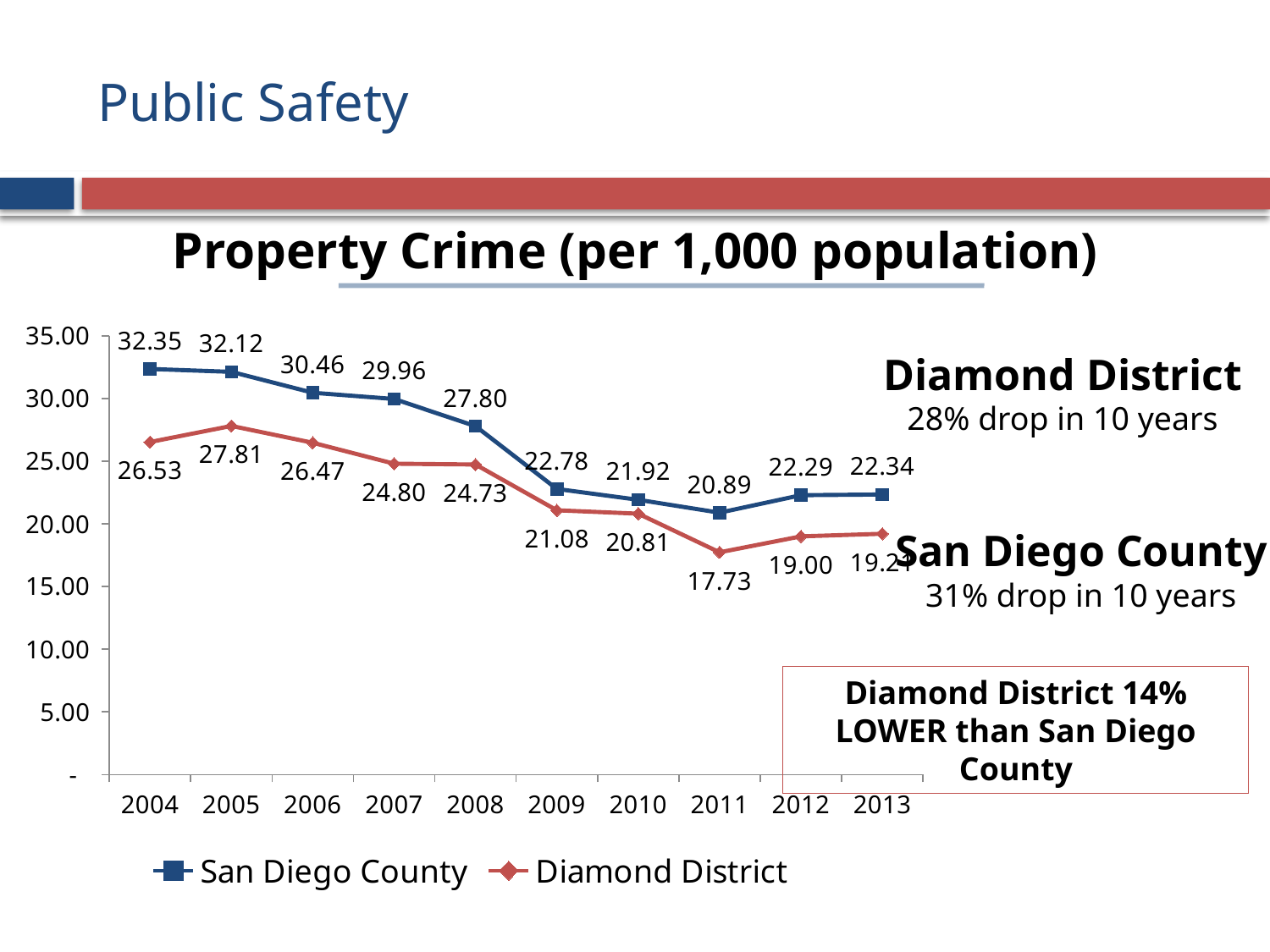
What is the San Diego County property crime rate in 2004? 32.35 In which year is the Diamond District value lowest? 2011 How many series does the legend list? 2 What is the difference between the San Diego County and Diamond District values in 2008? 3.07 What is the Diamond District value in 2007? 24.80 In which year is the San Diego County value highest? 2004 How many years are shown on the x axis? 10 What type of chart is shown on the slide? line chart Which series has the larger value in 2012, San Diego County or Diamond District? San Diego County What is the title of the chart? Property Crime (per 1,000 population) Overall, do the San Diego County values rise or fall from 2004 to 2013? fall What is the Diamond District property crime rate in 2011? 17.73